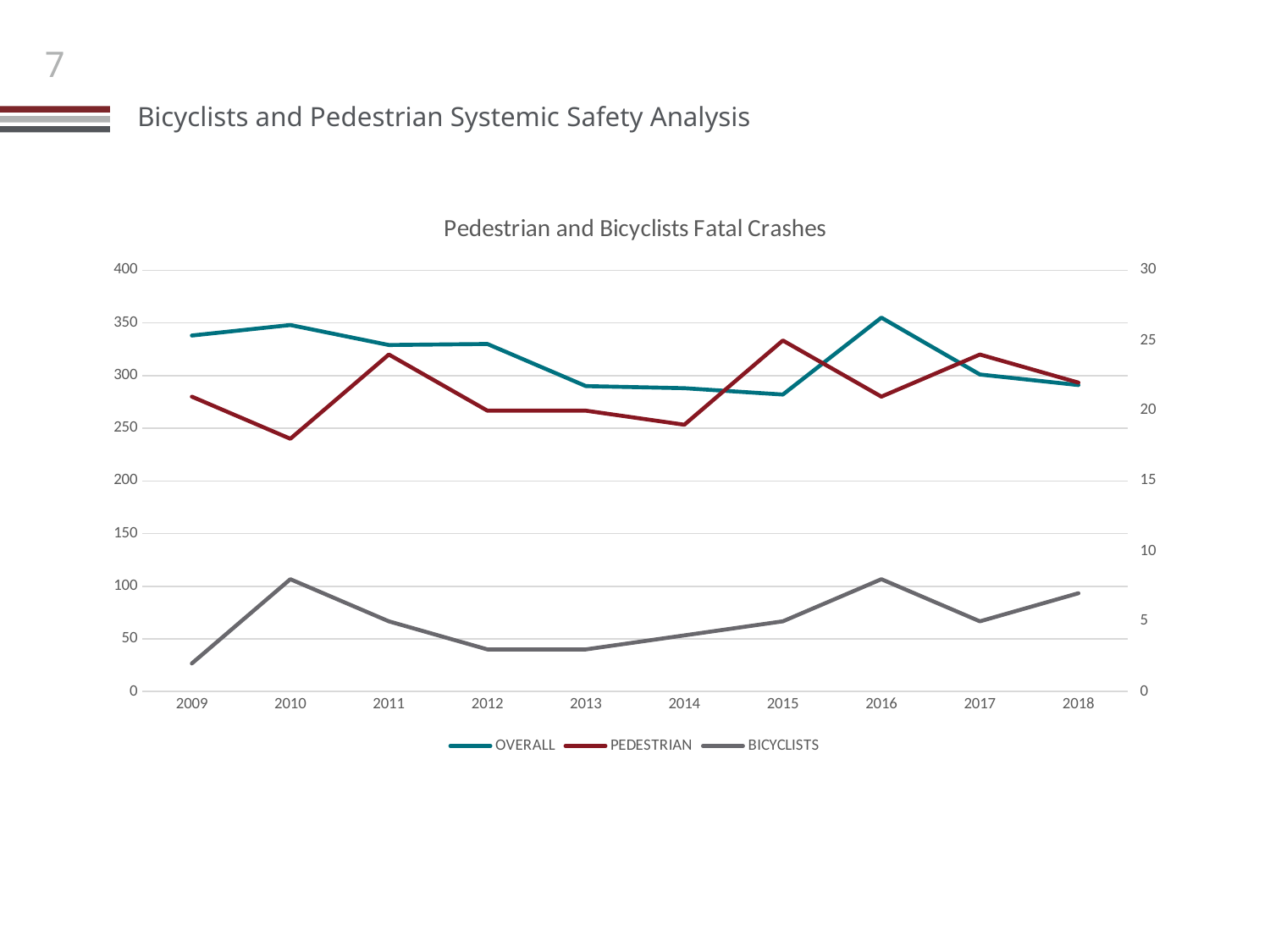
In which year does the PEDESTRIAN series reach its lowest value? 2010 What kind of chart is shown on the slide? line chart In which year does the OVERALL series reach its highest value? 2016 How many years are plotted along the x axis? 10 Is the OVERALL value for 2009 greater or less than 300 on the left axis? greater Does the OVERALL series rise or fall from 2016 to 2018? fall In which year does the BICYCLISTS series reach its lowest value? 2009 What is the title of the chart? Pedestrian and Bicyclists Fatal Crashes Which series is drawn in teal in the legend? OVERALL How many series does the legend list? 3